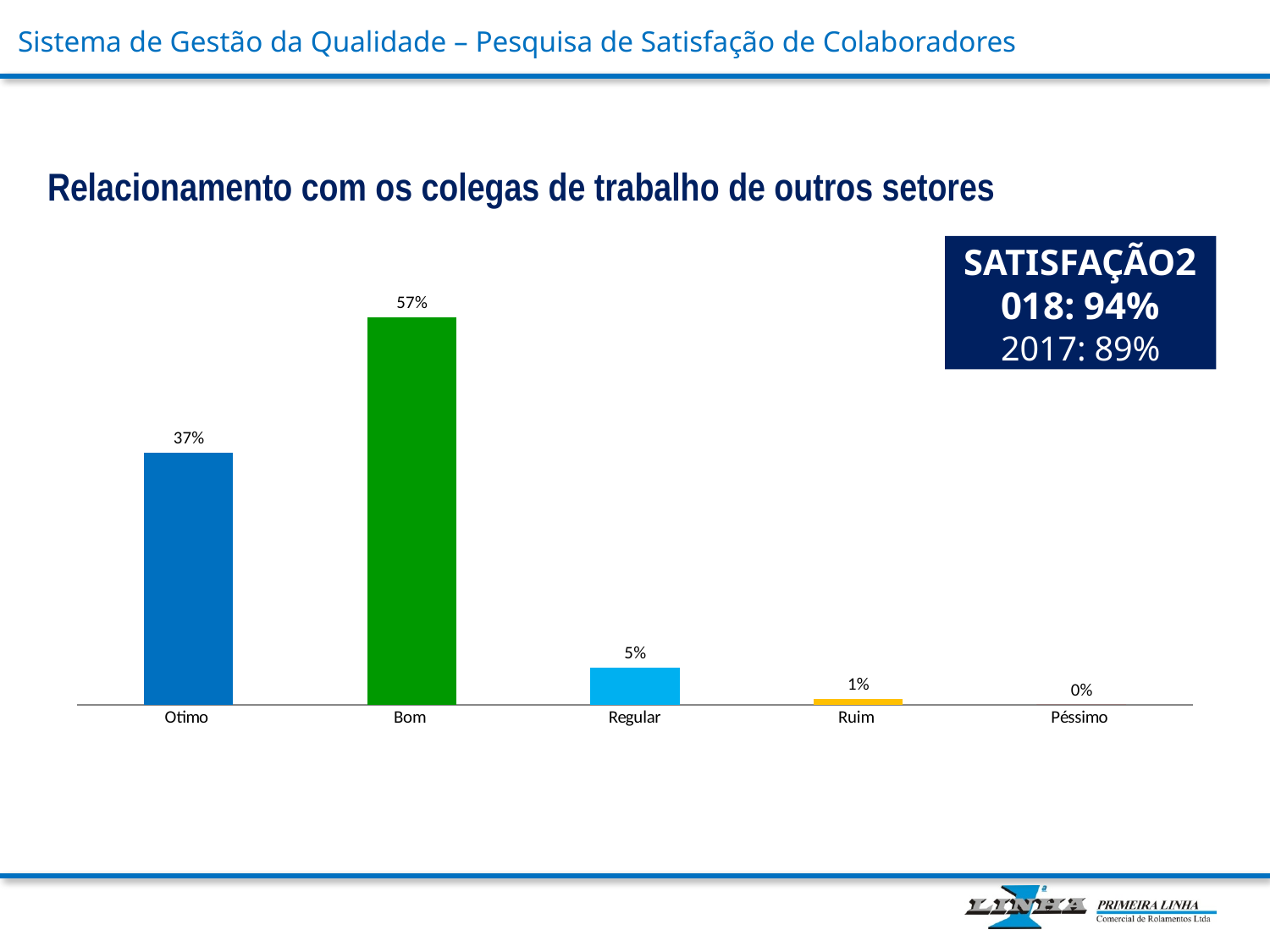
What is the value for Bom? 57% What is the difference between the values for Bom and Otimo? 20% Which category has the lowest value? Péssimo What is the value for Otimo? 37% What is the value for Regular? 5% What is the value for Ruim? 1% What colour is the bar for Bom? Green What is the value for Péssimo? 0% Which is larger, the value for Regular or the value for Ruim? Regular Which category has the highest value? Bom How many categories are shown on the x axis? 5 What kind of chart is shown on the slide? Bar chart